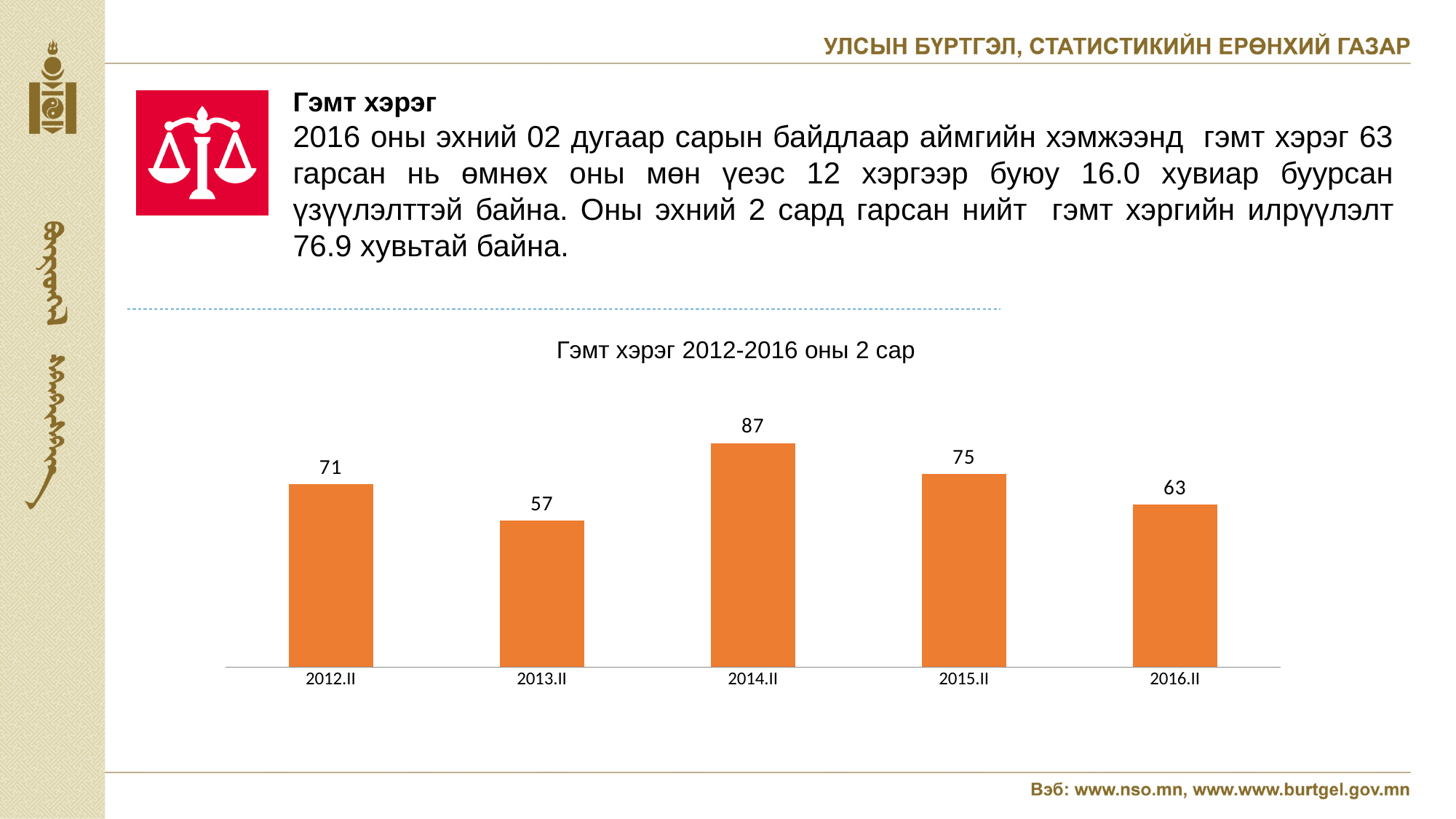
What is the value for 2014.II? 87 What is the title of the chart? Гэмт хэрэг 2012-2016 оны 2 сар Which category has the lowest value? 2013.II What kind of chart is shown on the slide? bar chart Which is larger, the value for 2012.II or the value for 2015.II? 2015.II Which category has the highest value? 2014.II How many categories are shown on the x axis? 5 What is the difference between the values for 2014.II and 2016.II? 24 What is the value for 2012.II? 71 What is the value for 2016.II? 63 What is the value for 2013.II? 57 What is the difference between the values for 2015.II and 2016.II? 12